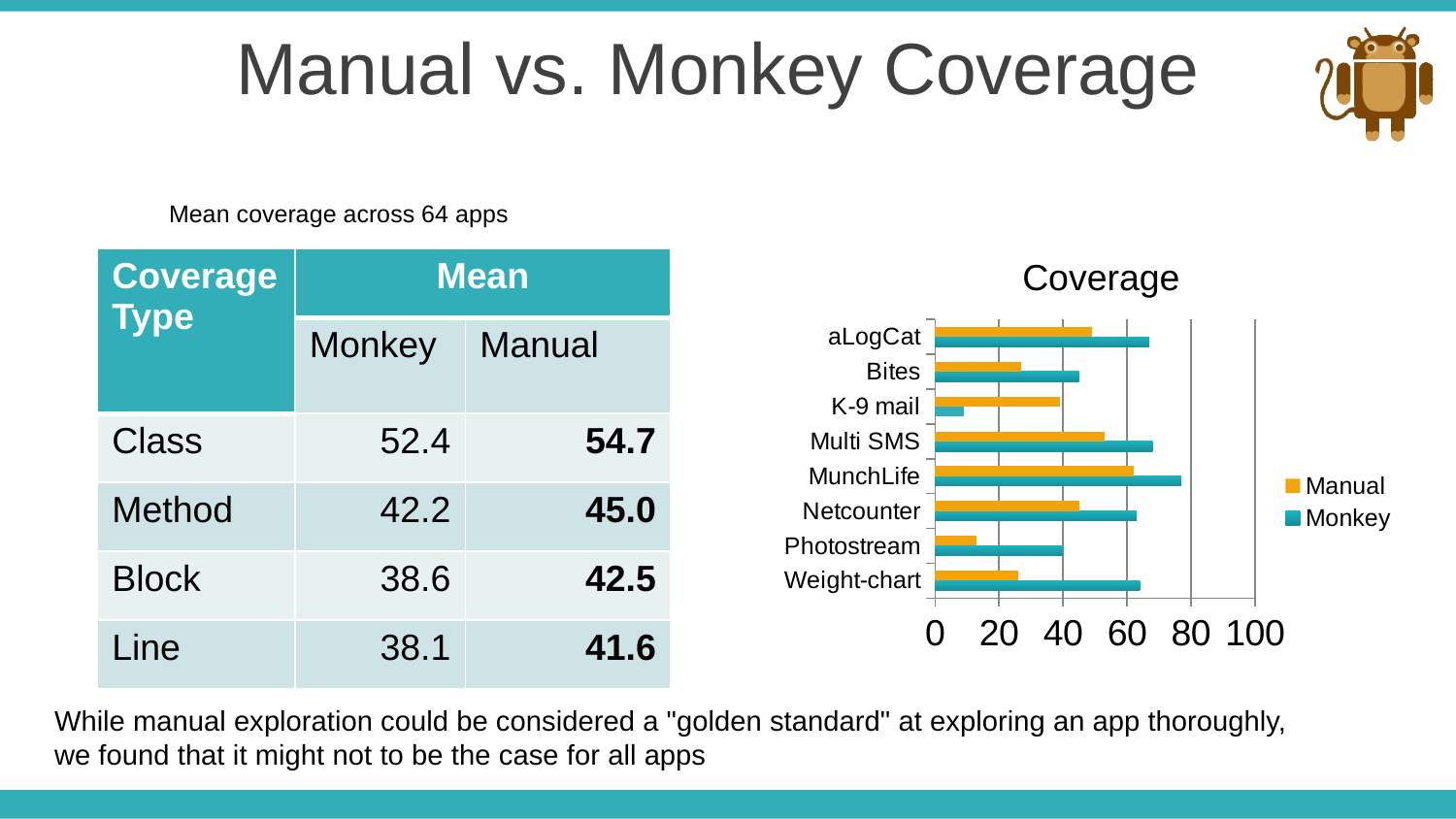
How many series does the legend of the Coverage chart list? 2 For Photostream, which is larger: Manual coverage or Monkey coverage? Monkey For K-9 mail, which is larger: Manual coverage or Monkey coverage? Manual Is the Manual coverage value for Photostream greater or less than 20? less Which app has the highest Monkey coverage in the chart? MunchLife Is the Monkey coverage value for MunchLife greater or less than 60? greater What are the two series named in the legend of the Coverage chart? Manual and Monkey Which app has the lowest Manual coverage in the chart? Photostream How many apps (categories) are plotted in the Coverage chart? 8 What kind of chart is shown on the slide? bar chart Which app has the lowest Monkey coverage in the chart? K-9 mail What is the title of the chart on the slide? Coverage